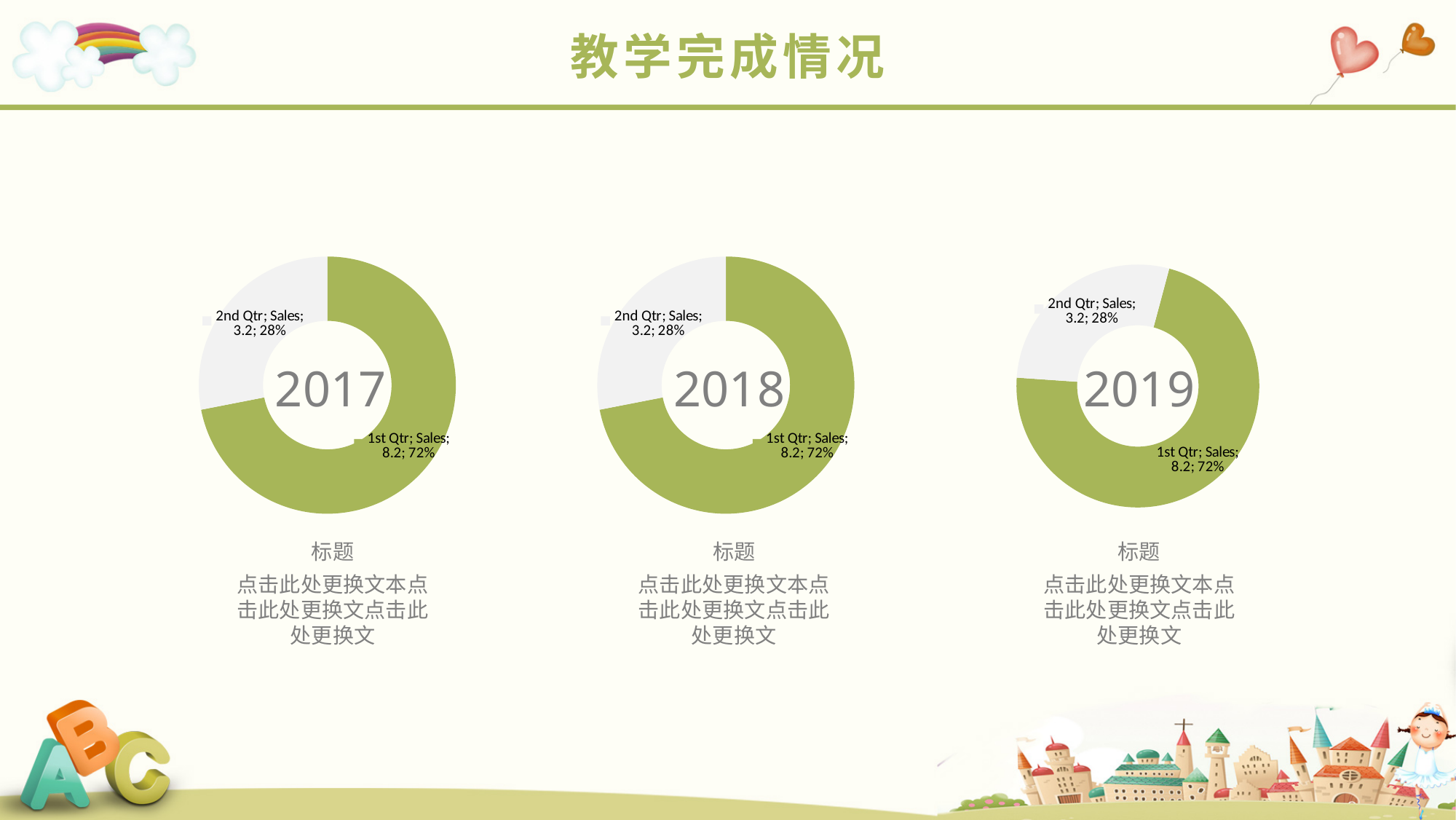
In the 2017 chart, what is the difference between the 1st Qtr and 2nd Qtr Sales values? 5.0 What kind of chart is the one labelled 2017? Doughnut chart What is the name of the data series shown in the 2017 chart's labels? Sales How many slices does the 2019 chart have? 2 In the 2018 chart, what share of the doughnut does 1st Qtr take? 72% In the 2017 chart, what is the Sales value for 2nd Qtr? 3.2 In the 2018 chart, which is larger, the 1st Qtr value or the 2nd Qtr value? 1st Qtr In the 2019 chart, which category has the largest slice? 1st Qtr In the 2018 chart, what share of the doughnut does 2nd Qtr take? 28% In the 2019 chart, which category has the smallest slice? 2nd Qtr In the 2017 chart, what is the Sales value for 1st Qtr? 8.2 How many doughnut charts are on the slide? 3